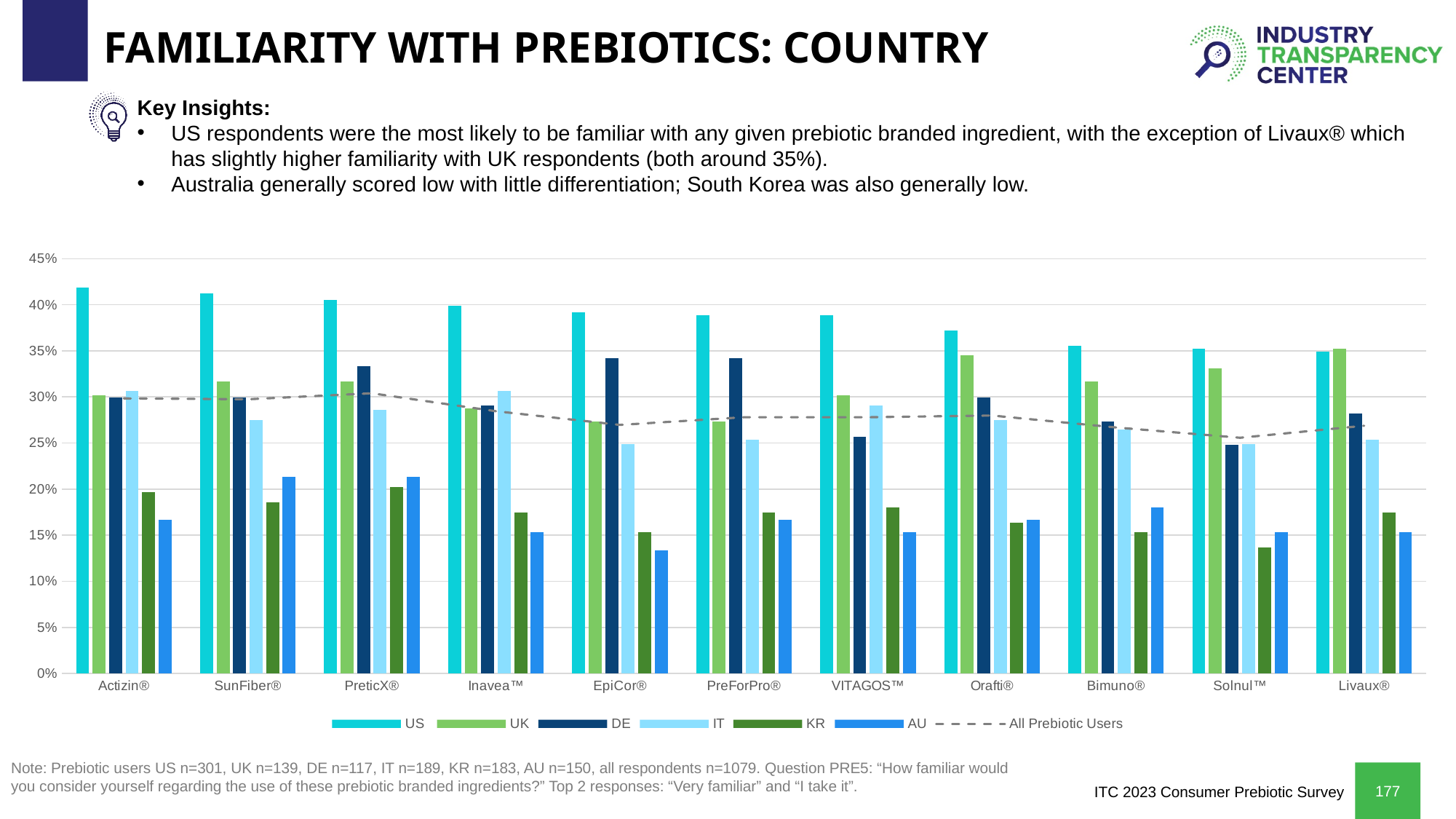
What kind of chart is shown on the slide? combination bar and line chart For Actizin®, which is larger: the US value or the KR value? US Is the US value for Actizin® greater or less than 40%? greater Which country has the lowest familiarity value for Actizin®? AU Is the KR value for Solnul™ greater or less than 15%? less Is the AU value for EpiCor® greater or less than 15%? less Does the US series generally rise or fall moving from Actizin® to Livaux® along the x axis? fall For EpiCor®, which is larger: the DE value or the IT value? DE How many entries does the chart legend list? 7 How many prebiotic branded ingredients are shown on the x axis of the chart? 11